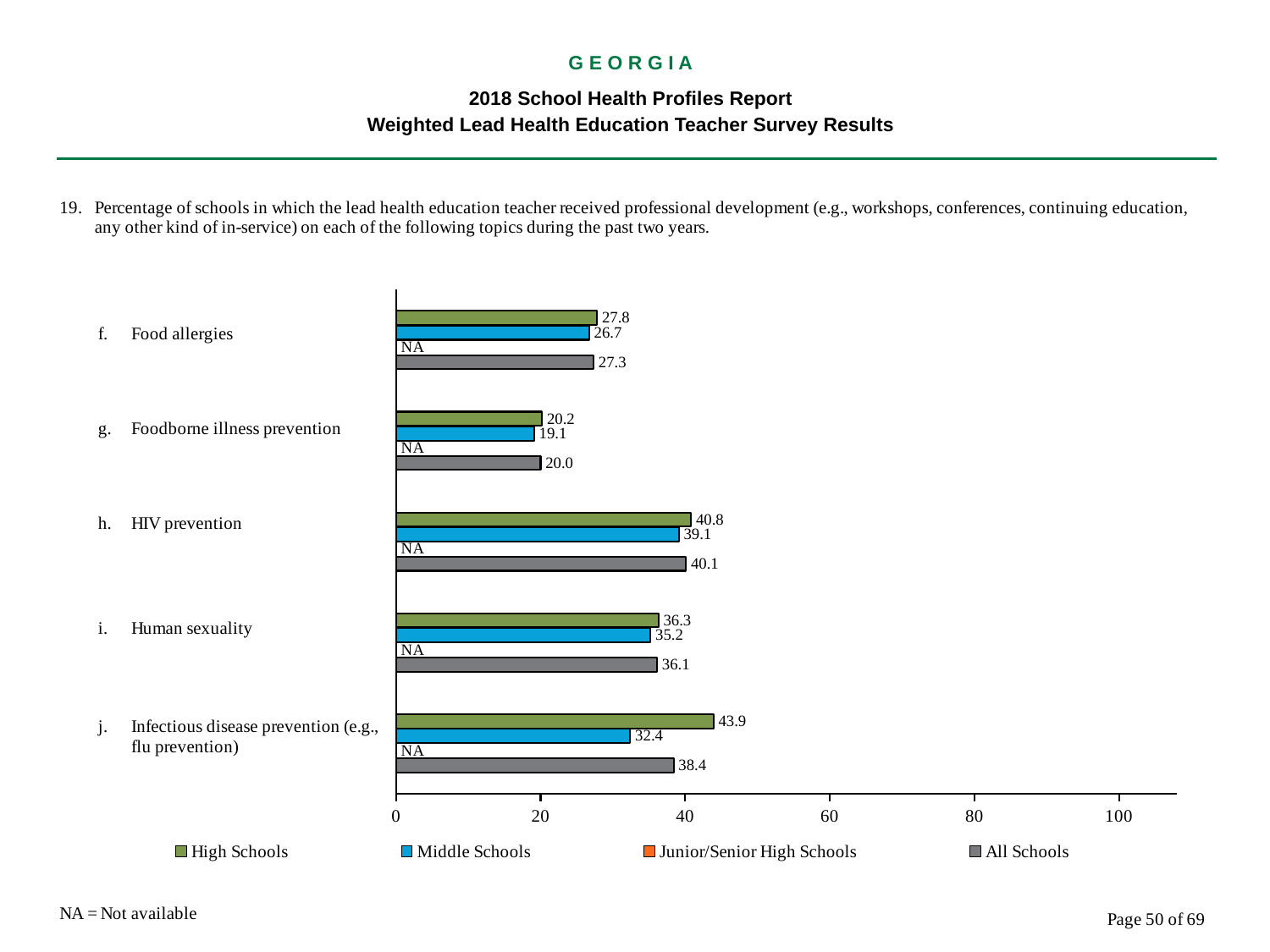
What value is shown for Junior/Senior High Schools for HIV prevention? NA Which topic has the highest value for High Schools? Infectious disease prevention (e.g., flu prevention) How many topics are shown on the chart? 5 How many series does the legend list? 4 Is the value for All Schools for Food allergies greater or less than 40? less What is the value for Middle Schools for Foodborne illness prevention? 19.1 What is the value for All Schools for HIV prevention? 40.1 Which is larger for Human sexuality: the High Schools value or the Middle Schools value? High Schools What is the value for High Schools for Infectious disease prevention (e.g., flu prevention)? 43.9 What is the difference between the High Schools and Middle Schools values for Infectious disease prevention (e.g., flu prevention)? 11.5 What kind of chart is shown on the slide? bar chart Which topic has the lowest value for All Schools? Foodborne illness prevention